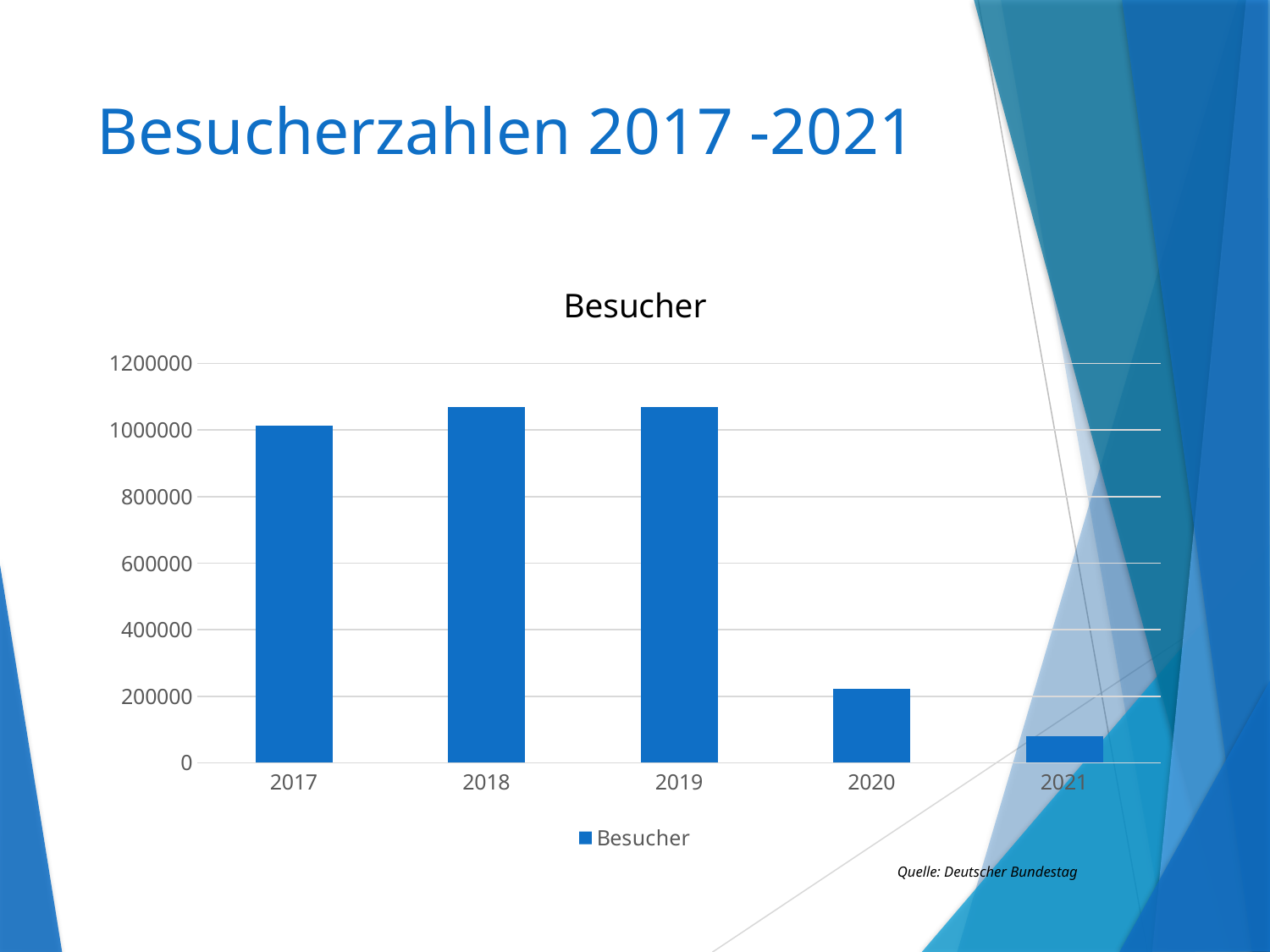
What kind of chart is shown on the slide? bar chart Which year has more Besucher, 2017 or 2020? 2017 What is the title of the chart? Besucher How many series does the chart's legend list? 1 Is the value for 2020 greater or less than 400000? less Is the value for 2021 greater or less than 200000? less How many years are shown on the x axis of the chart? 5 Is the value for 2018 greater or less than 1000000? greater Do the values rise or fall from 2019 to 2021? fall Which year has more Besucher, 2020 or 2021? 2020 Which year has the lowest number of Besucher? 2021